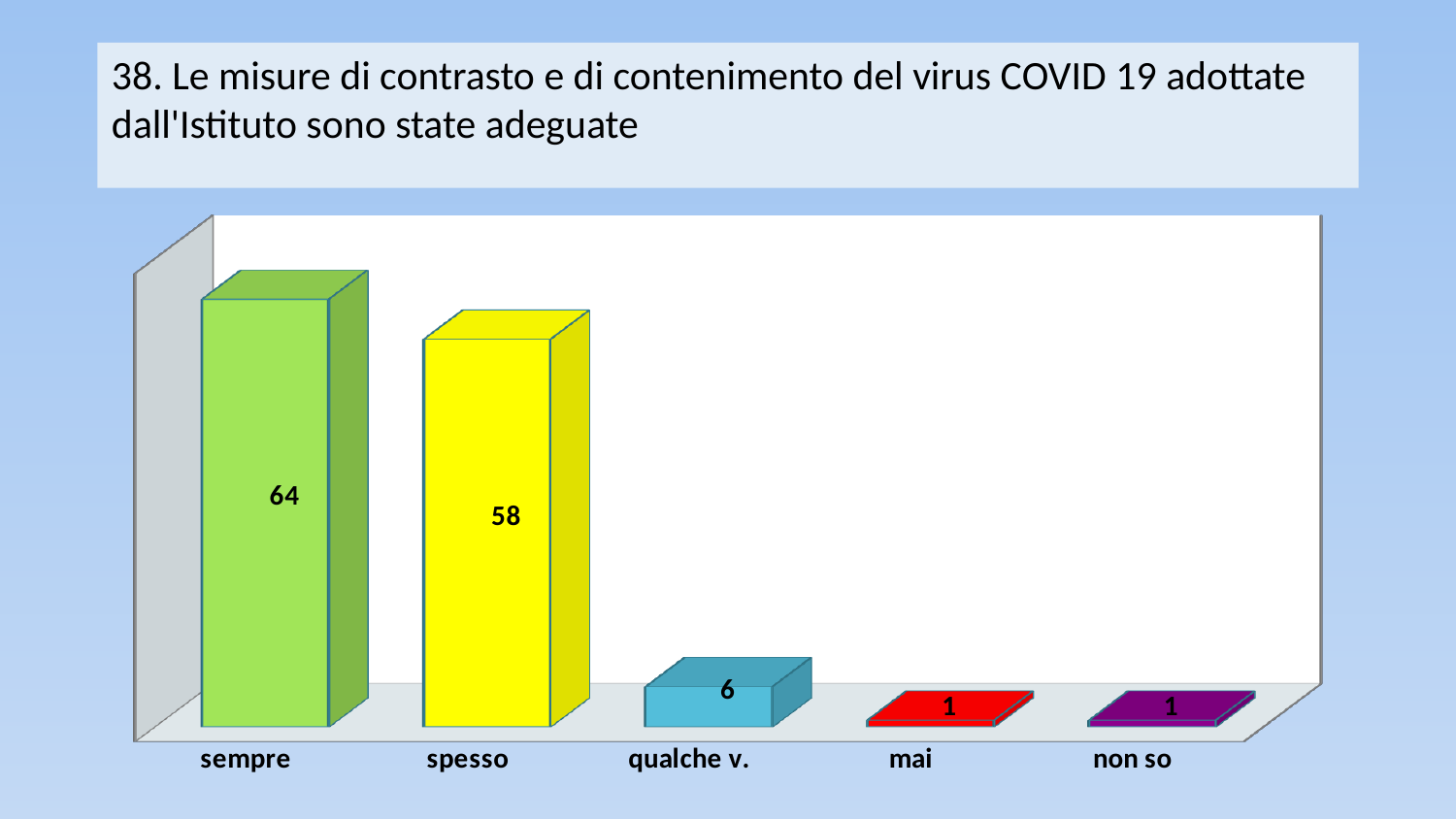
What colour is the bar for "spesso"? yellow What is the value for "spesso"? 58 Do the values rise or fall from left to right along the x axis? fall Which category has the highest value? sempre What kind of chart is shown on the slide? bar chart What is the difference between the values for "spesso" and "qualche v."? 52 How many categories are shown on the x axis? 5 What is the value for "mai"? 1 Which is larger, the value for "spesso" or the value for "qualche v."? spesso What is the difference between the values for "sempre" and "spesso"? 6 What is the value for "sempre"? 64 What is the value for "qualche v."? 6